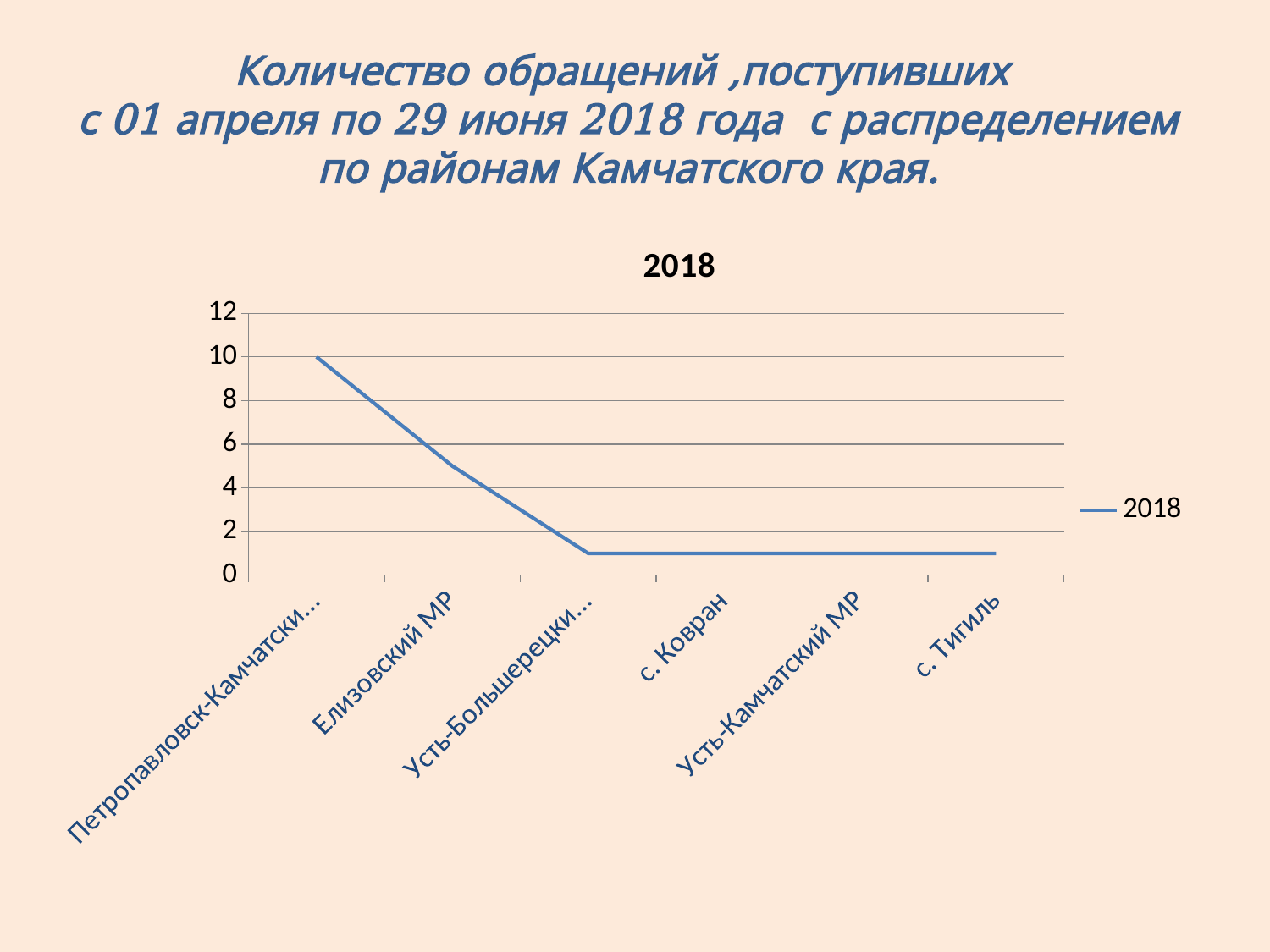
Is the value for Елизовский МР greater or less than 4? greater Which is larger, the value for Елизовский МР or the value for Усть-Камчатский МР? Елизовский МР Is the value for с. Ковран greater or less than 2? less Do the values rise or fall moving from left to right along the x axis? fall What is the title shown above the chart? 2018 How many categories are plotted along the x axis? 6 Is the value for Елизовский МР greater or less than 6? less Which category has the highest value? Петропавловск-Камчатски... How many series does the legend list? 1 What kind of chart is shown on the slide? line chart What is the value for Петропавловск-Камчатски...? 10